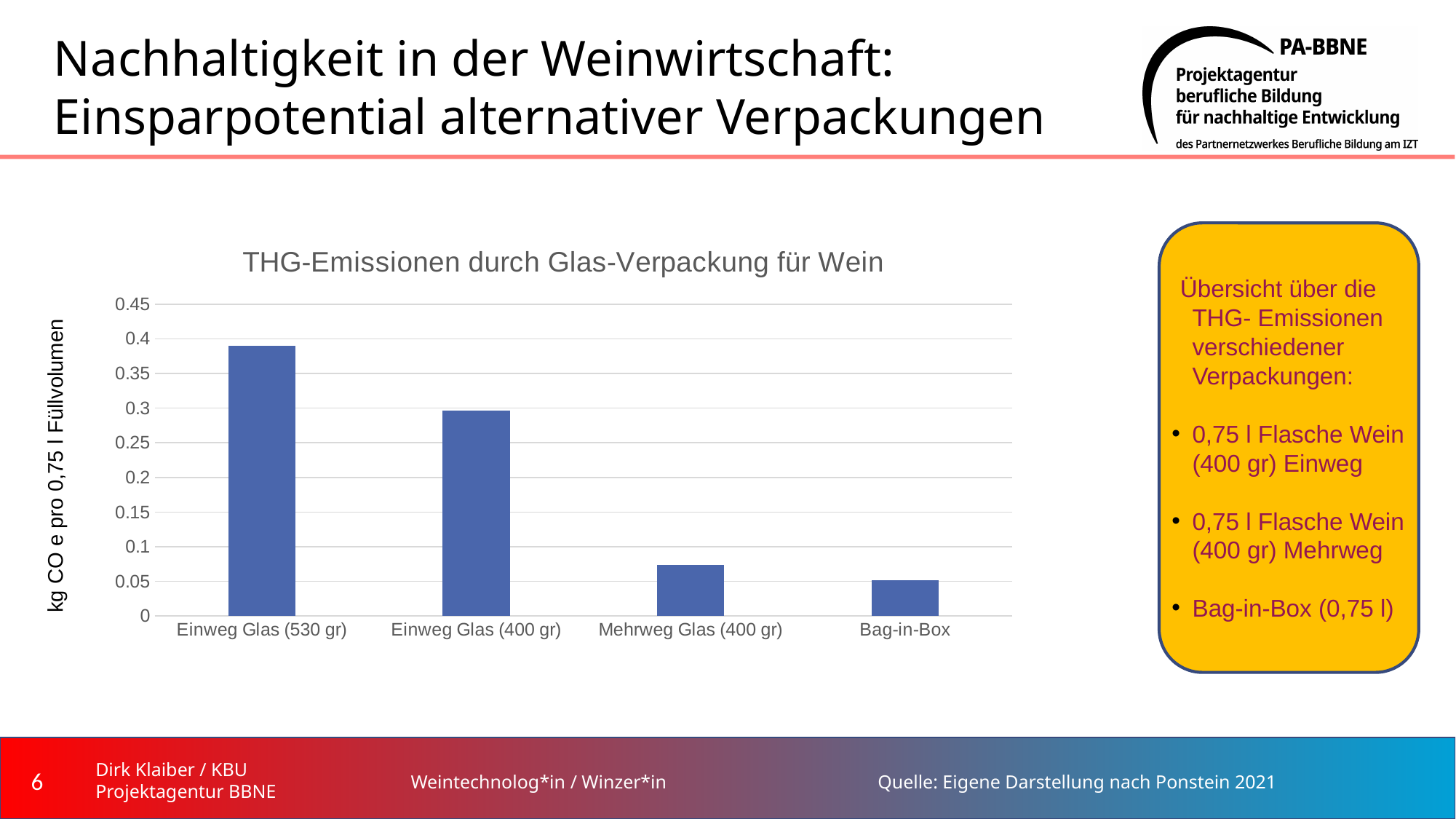
What kind of chart is shown on the slide? bar chart Which category has the lowest value in the chart? Bag-in-Box Is the value for Einweg Glas (400 gr) greater or less than 0.25? greater Which is larger, the value for Einweg Glas (530 gr) or Einweg Glas (400 gr)? Einweg Glas (530 gr) Which is larger, the value for Mehrweg Glas (400 gr) or Bag-in-Box? Mehrweg Glas (400 gr) Do the values rise or fall from left to right along the x axis? fall How many categories are shown on the x axis of the chart? 4 What is the title of the chart? THG-Emissionen durch Glas-Verpackung für Wein Is the value for Mehrweg Glas (400 gr) greater or less than 0.1? less Is the value for Bag-in-Box greater or less than 0.1? less Which category has the highest value in the chart? Einweg Glas (530 gr)